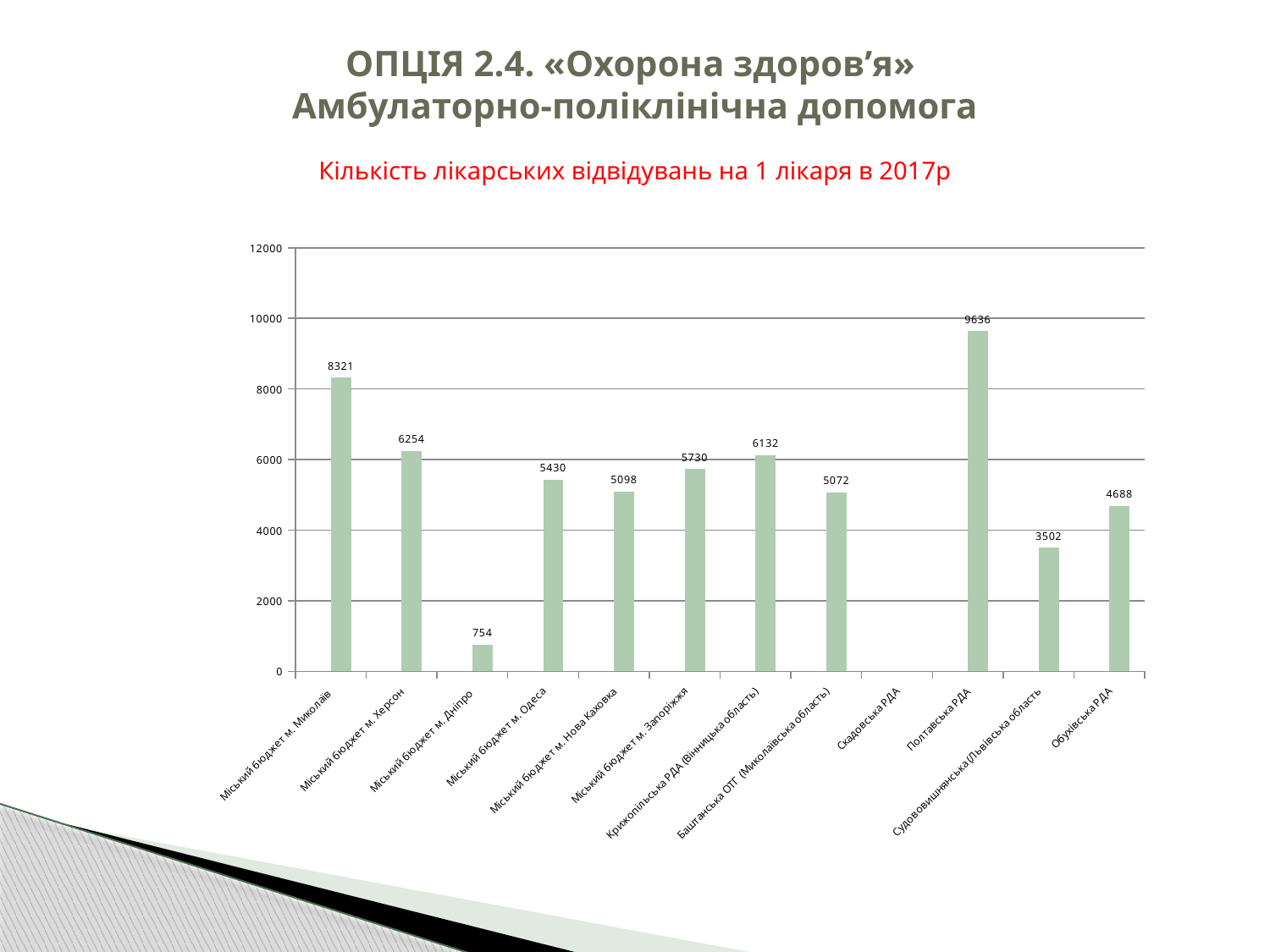
What is the value for Міський бюджет м. Миколаїв? 8321 Which category has the highest value? Полтавська РДА What is the title of the chart? Кількість лікарських відвідувань на 1 лікаря в 2017р Which category with a plotted bar has the lowest value? Міський бюджет м. Дніпро What kind of chart is shown on the slide? bar chart What is the value for Міський бюджет м. Дніпро? 754 What is the difference between the values for Полтавська РДА and Міський бюджет м. Миколаїв? 1315 Which is larger, the value for Міський бюджет м. Херсон or the value for Крижопільська РДА (Вінницька область)? Міський бюджет м. Херсон How many categories are listed on the x axis? 12 Is the value for Обухівська РДА greater or less than 4000? greater What is the value for Полтавська РДА? 9636 What is the value for Судововишнянська (Львівська область)? 3502